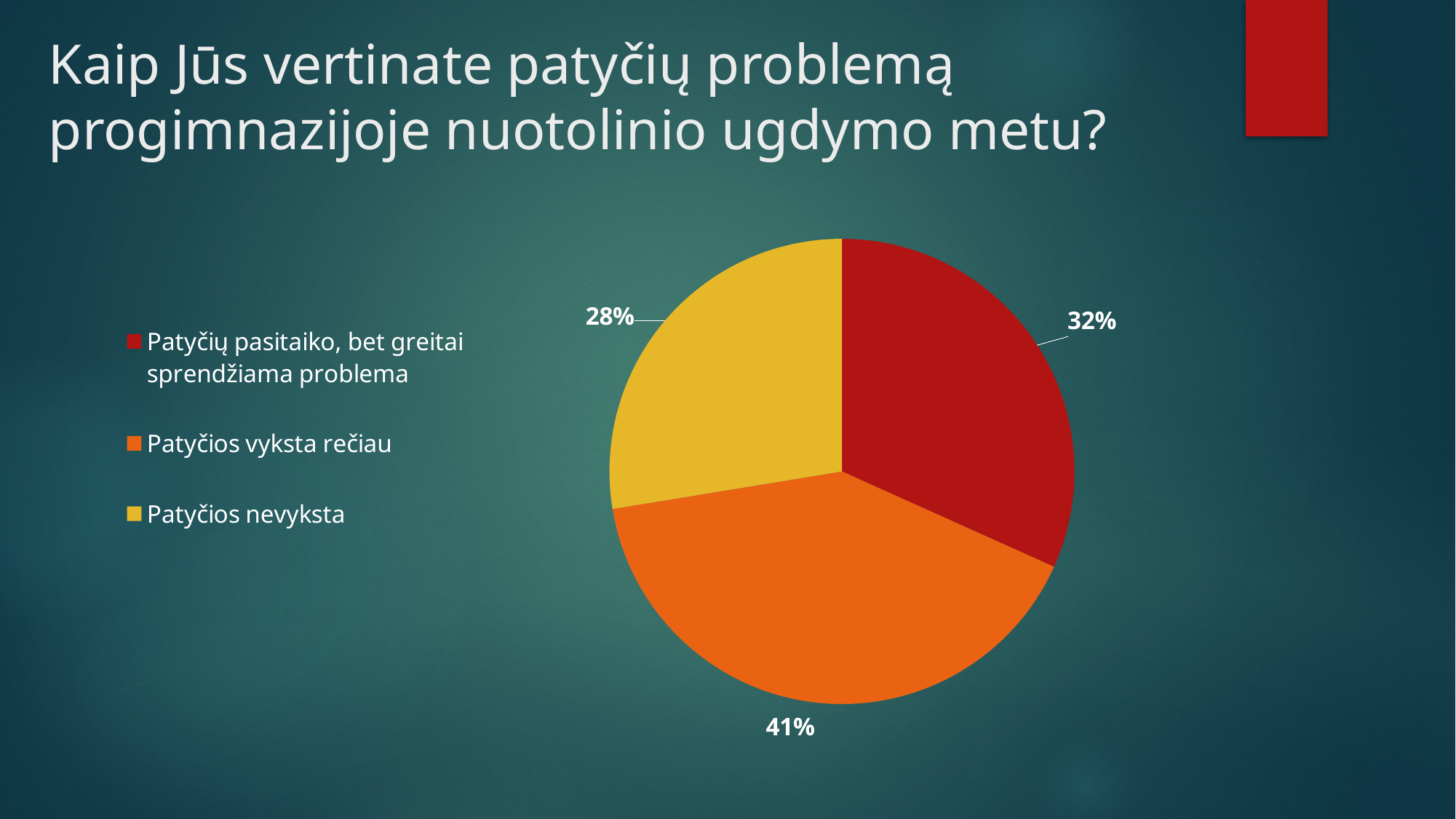
Which is larger: the share for "Patyčių pasitaiko, bet greitai sprendžiama problema" or the share for "Patyčios nevyksta"? Patyčių pasitaiko, bet greitai sprendžiama problema What is the difference in percentage points between "Patyčios vyksta rečiau" and "Patyčios nevyksta"? 13 What percentage is shown for "Patyčių pasitaiko, bet greitai sprendžiama problema"? 32% What kind of chart is shown on the slide? pie chart How many categories does the pie chart have? 3 How many entries does the legend list? 3 What is the difference in percentage points between "Patyčios vyksta rečiau" and "Patyčių pasitaiko, bet greitai sprendžiama problema"? 9 What percentage is shown for "Patyčios nevyksta"? 28% Which category has the smallest share of the pie? Patyčios nevyksta Which category has the largest share of the pie? Patyčios vyksta rečiau What percentage is shown for "Patyčios vyksta rečiau"? 41% What colour is the slice for "Patyčios nevyksta"? yellow